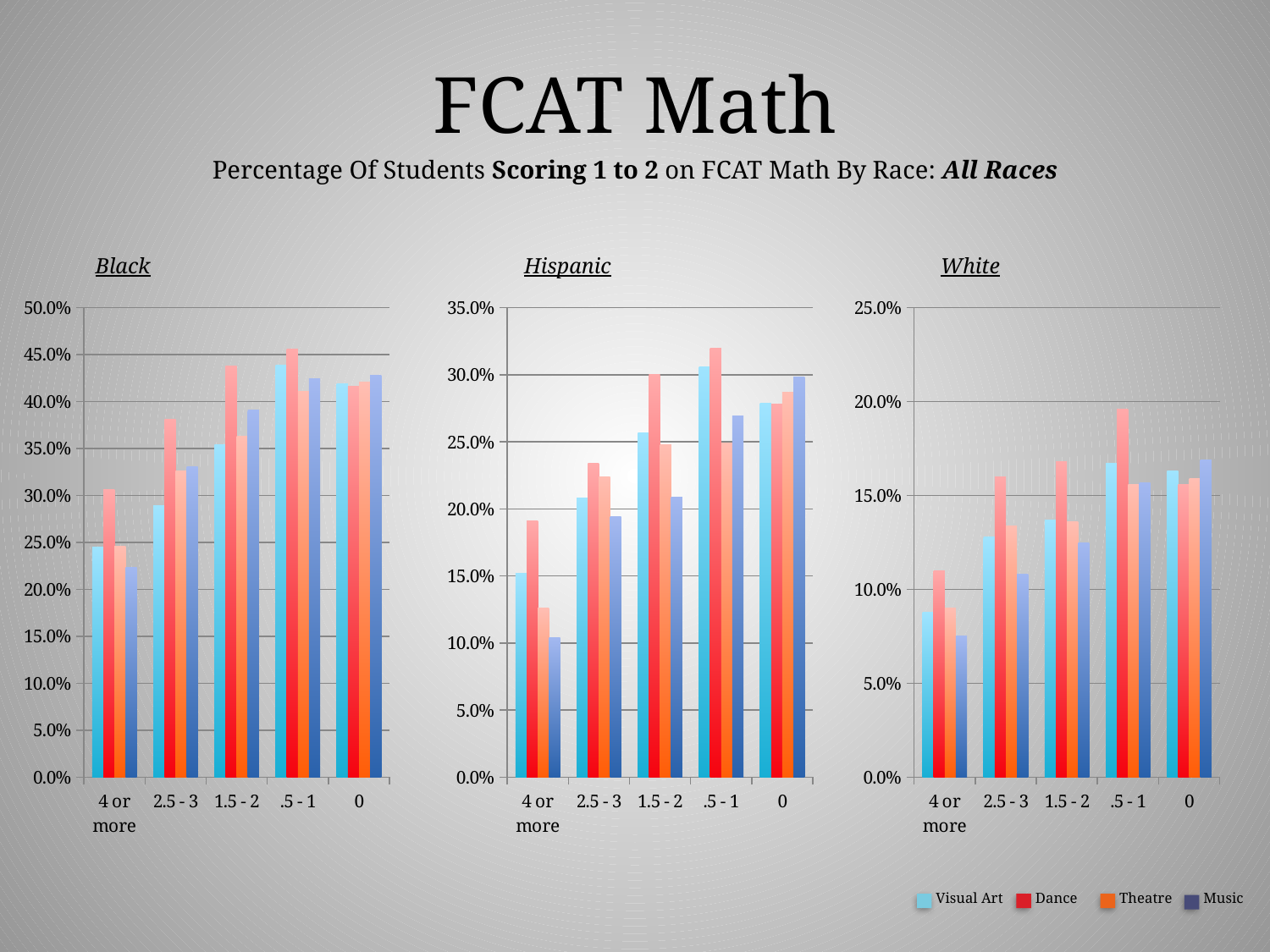
What kind of chart is the Black chart? bar chart In the White chart, which is larger at "4 or more": Dance or Music? Dance How many series does the legend list? 4 How many categories are shown on the x axis of the Hispanic chart? 5 In the Hispanic chart, is the value for Dance at ".5 - 1" greater or less than 30%? greater In the White chart, is the value for Visual Art at "4 or more" greater or less than 10%? less In the Hispanic chart, is the value for Dance at "4 or more" greater or less than 20%? less In the Black chart, which series has the highest value at "4 or more"? Dance In the Hispanic chart, which series has the lowest value at "4 or more"? Music What is the subtitle of the slide describing the charts? Percentage Of Students Scoring 1 to 2 on FCAT Math By Race: All Races